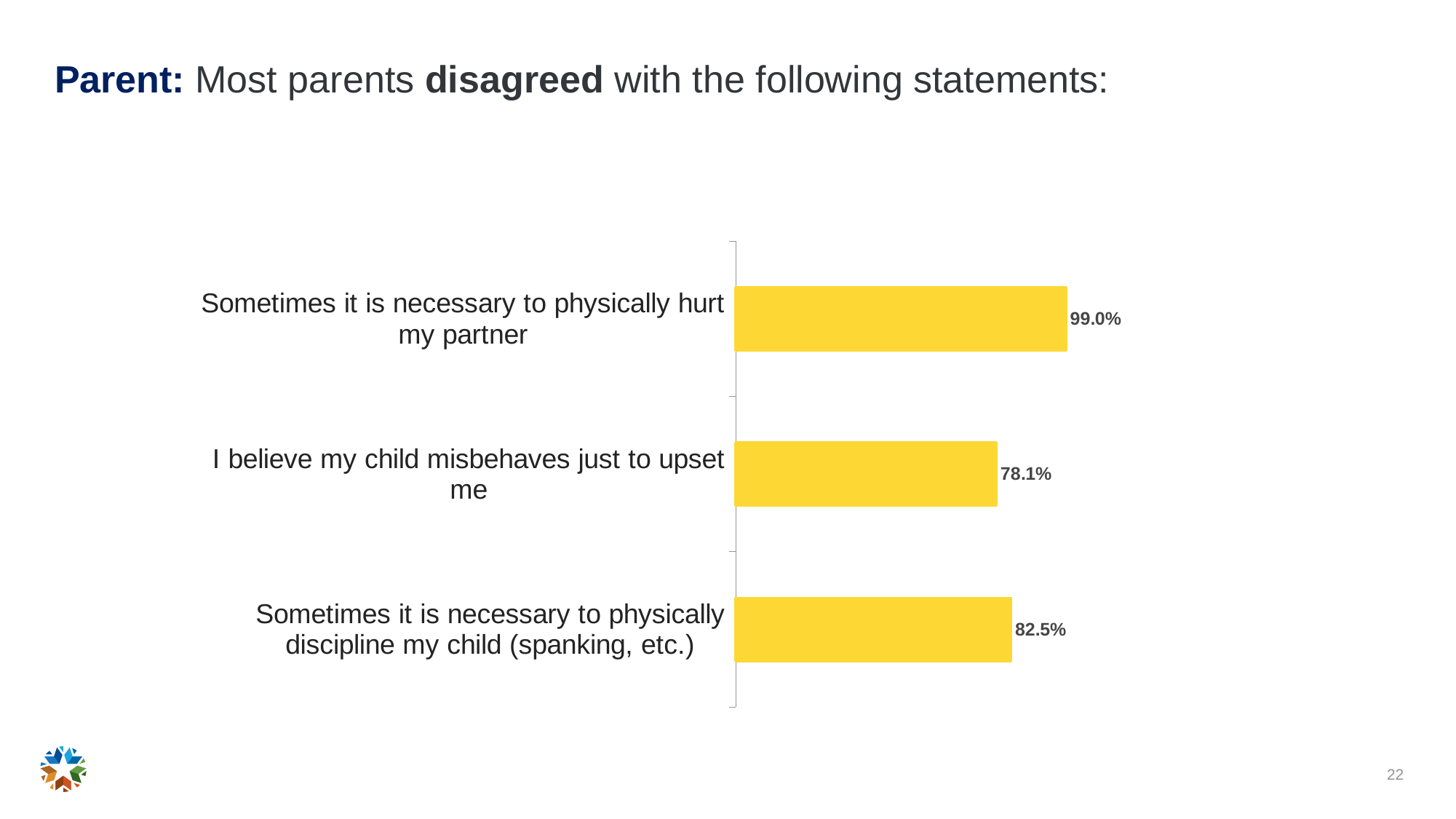
What is the difference in percentage points between the disagreement with "Sometimes it is necessary to physically discipline my child (spanking, etc.)" and "I believe my child misbehaves just to upset me"? 4.4 What is the difference in percentage points between the disagreement with "Sometimes it is necessary to physically hurt my partner" and "I believe my child misbehaves just to upset me"? 20.9 What colour are the bars in the chart? Yellow What percentage of parents disagreed with the statement "I believe my child misbehaves just to upset me"? 78.1% What percentage of parents disagreed with the statement "Sometimes it is necessary to physically discipline my child (spanking, etc.)"? 82.5% Which statement had a larger share of parents disagreeing: "Sometimes it is necessary to physically discipline my child (spanking, etc.)" or "I believe my child misbehaves just to upset me"? Sometimes it is necessary to physically discipline my child (spanking, etc.) Which statement has the lowest percentage of parents disagreeing? I believe my child misbehaves just to upset me What type of chart is shown on the slide? Bar chart What percentage of parents disagreed with the statement "Sometimes it is necessary to physically hurt my partner"? 99.0% Which statement has the highest percentage of parents disagreeing? Sometimes it is necessary to physically hurt my partner According to the slide title, did most parents agree or disagree with the statements shown? Disagreed How many statements are shown in the chart? 3